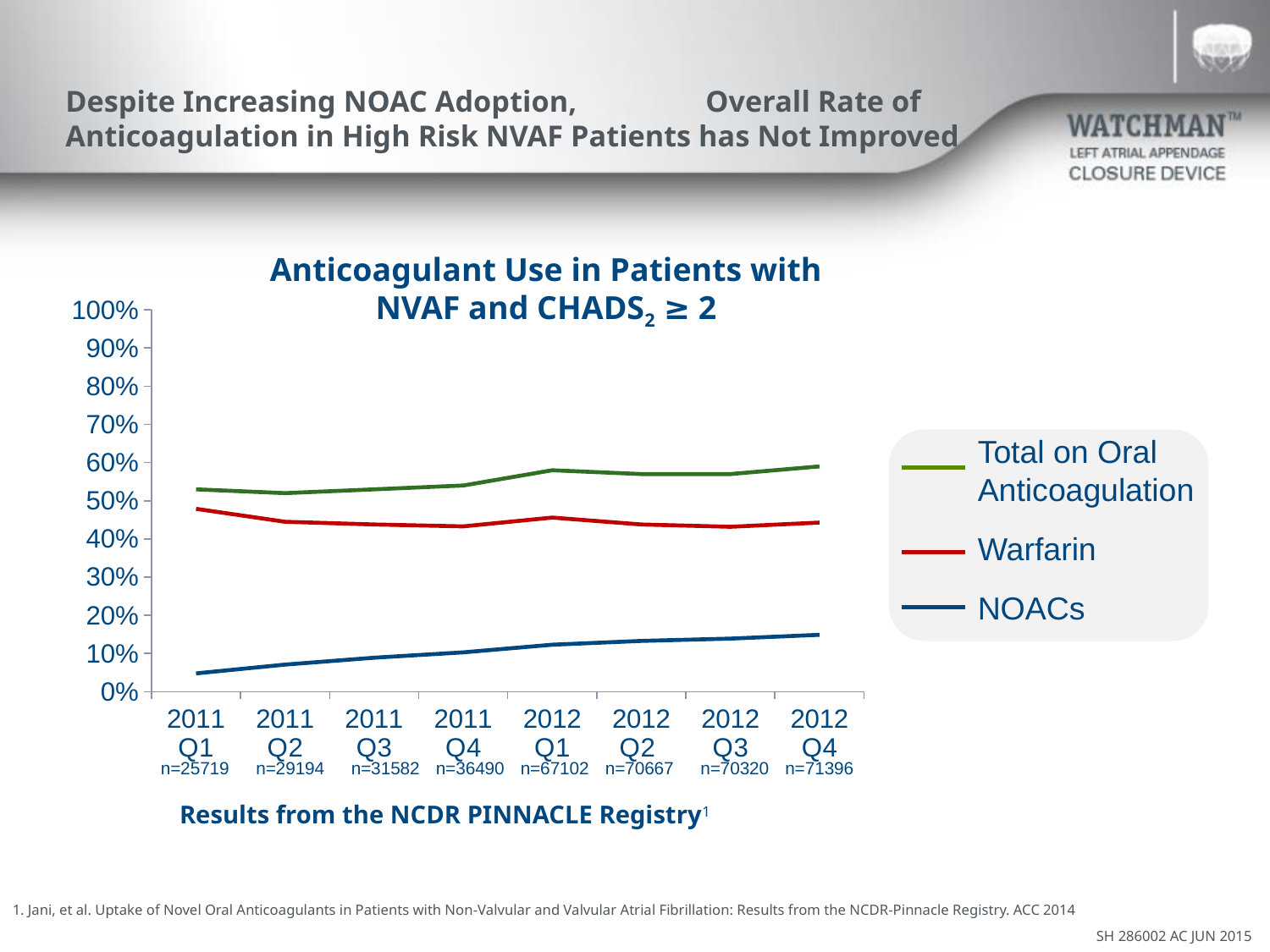
Which series has the lowest values across all quarters? NOACs What kind of chart is shown on the slide? line chart Is the value for NOACs in 2012 Q4 greater or less than 10%? greater Is the value for NOACs in 2011 Q1 greater or less than 10%? less Does the NOACs line rise or fall from 2011 Q1 to 2012 Q4? rise In 2012 Q4, which is larger: the value for Warfarin or the value for NOACs? Warfarin What colour is the Warfarin line? red Which series has the highest values across all quarters? Total on Oral Anticoagulation Is the value for Warfarin in 2012 Q3 greater or less than 50%? less How many series does the legend list? 3 How many quarters are plotted along the x axis? 8